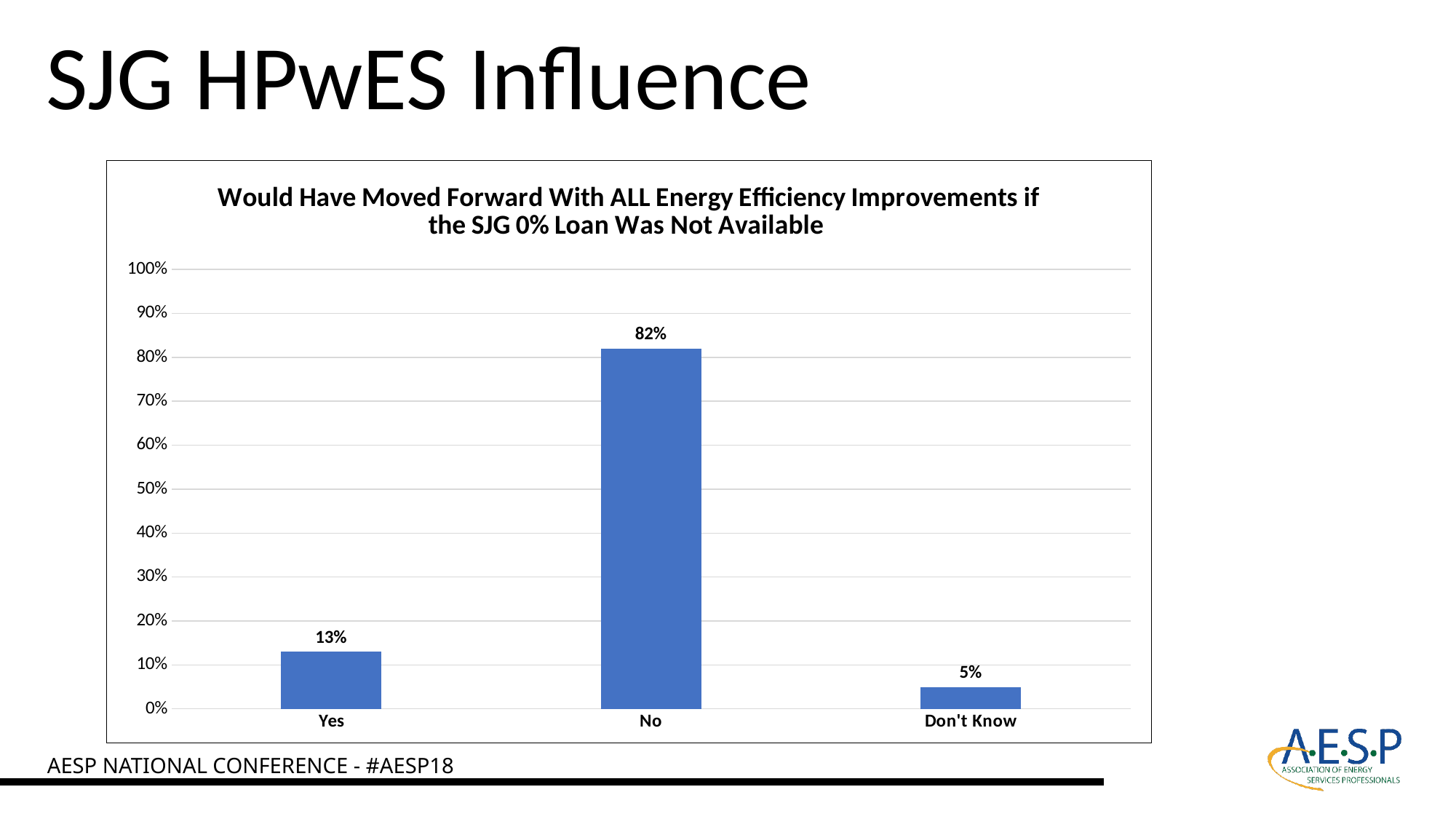
What is the value for the "No" category? 82% What kind of chart is shown on the slide? Bar chart Which category has the highest value? No What is the title of the chart? Would Have Moved Forward With ALL Energy Efficiency Improvements if the SJG 0% Loan Was Not Available How many categories are shown on the x axis? 3 What is the value for the "Yes" category? 13% Which category has the lowest value? Don't Know What is the difference between the values for "Yes" and "Don't Know"? 8% What is the difference between the values for "No" and "Yes"? 69% Which is larger, the value for "Yes" or the value for "Don't Know"? Yes What is the value for the "Don't Know" category? 5% Is the value for "No" greater or less than 50%? greater